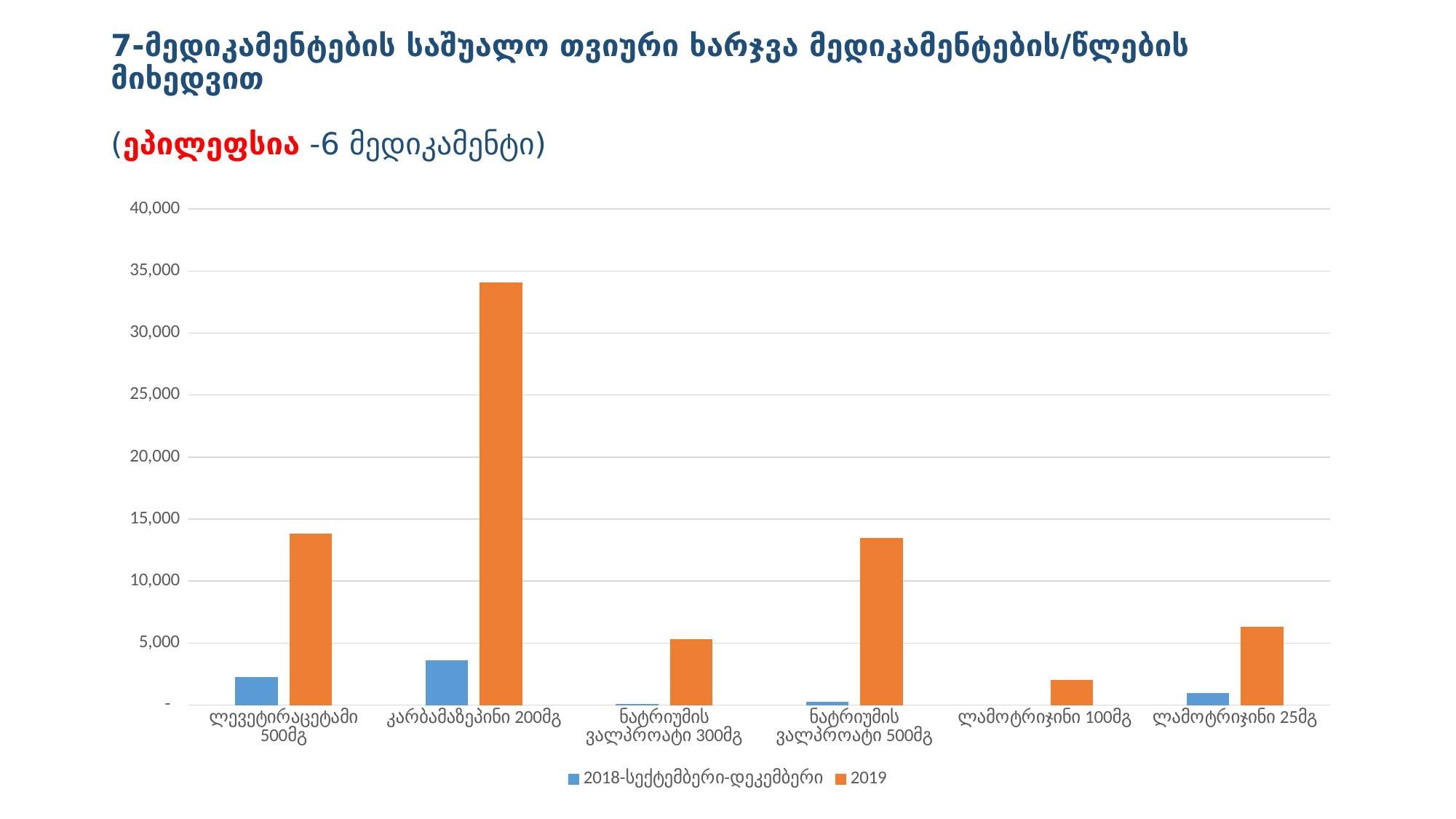
Is the 2019 value for ნატრიუმის ვალპროატი 300მგ greater or less than 10,000? less How many series does the legend list? 2 Which category has the highest value for the 2019 series? კარბამაზეპინი 200მგ Which category has the lowest value for the 2019 series? ლამოტრიჯინი 100მგ Is the 2019 value for კარბამაზეპინი 200მგ greater or less than 30,000? greater How many medication categories are shown on the x axis? 6 Which category has the highest value for the 2018-სექტემბერი-დეკემბერი series? კარბამაზეპინი 200მგ In the 2019 series, which is larger: ლამოტრიჯინი 25მგ or ლამოტრიჯინი 100მგ? ლამოტრიჯინი 25მგ What colour represents the 2019 series in the legend? Orange For კარბამაზეპინი 200მგ, which series has the larger value: 2018-სექტემბერი-დეკემბერი or 2019? 2019 Is the 2019 value for ლევეტირაცეტამი 500მგ greater or less than 10,000? greater What kind of chart is shown on the slide? Bar chart